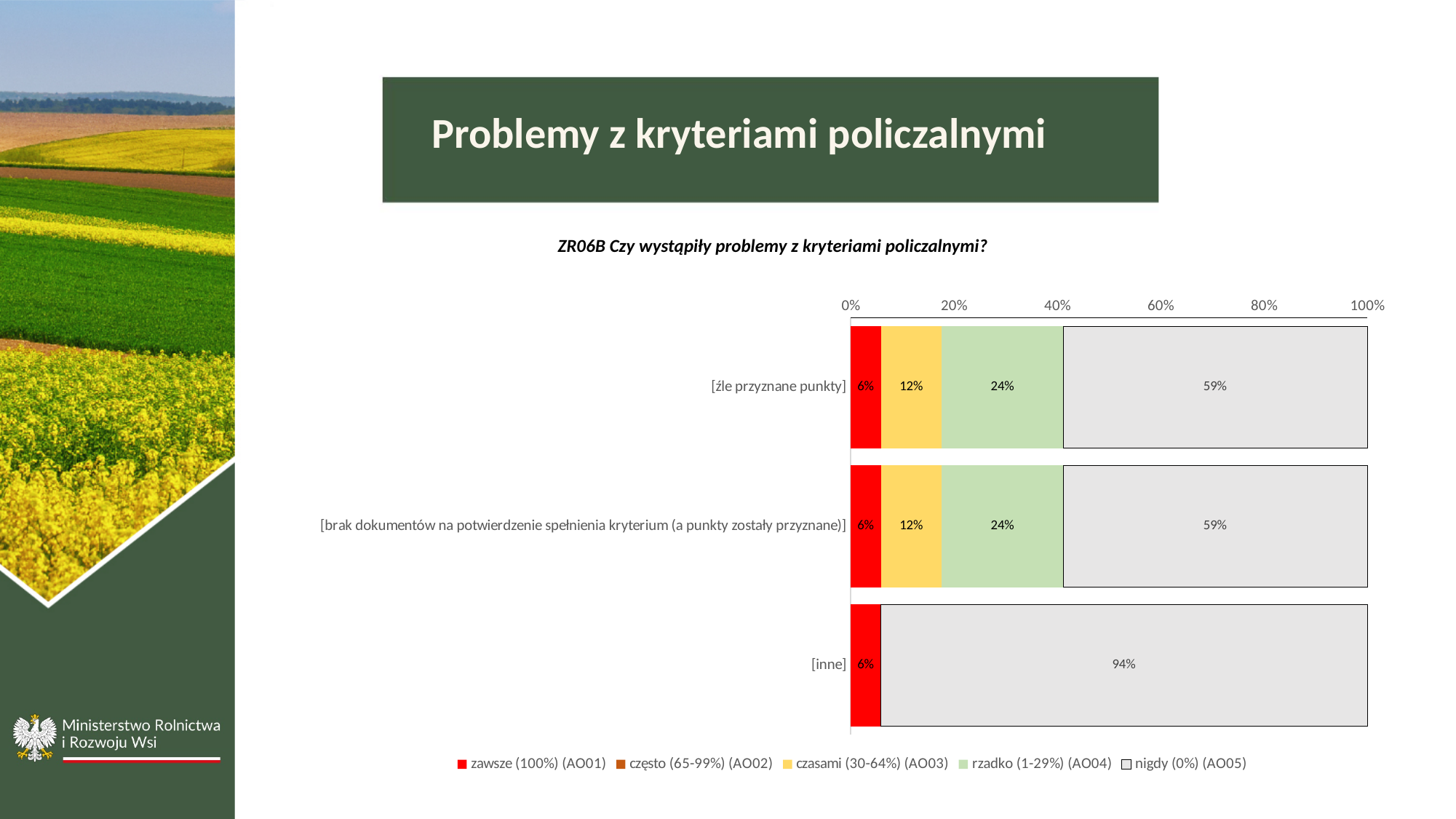
Which is larger for '[źle przyznane punkty]': the 'rzadko (1-29%) (AO04)' value or the 'czasami (30-64%) (AO03)' value? rzadko (1-29%) (AO04) What is the value of 'nigdy (0%) (AO05)' for the category '[inne]'? 94% What is the value of 'czasami (30-64%) (AO03)' for the category '[brak dokumentów na potwierdzenie spełnienia kryterium (a punkty zostały przyznane)]'? 12% What is the value of 'zawsze (100%) (AO01)' for the category '[inne]'? 6% How many series does the legend list? 5 What kind of chart is shown on the slide? stacked bar chart What is the title of the chart? ZR06B Czy wystąpiły problemy z kryteriami policzalnymi? What is the value of 'rzadko (1-29%) (AO04)' for the category '[źle przyznane punkty]'? 24% Which category has the highest value for 'nigdy (0%) (AO05)'? [inne] How many categories are plotted on the chart? 3 What is the difference between the 'nigdy (0%) (AO05)' value for '[inne]' and for '[źle przyznane punkty]'? 35% Is the 'nigdy (0%) (AO05)' value for '[inne]' greater or less than 80%? greater